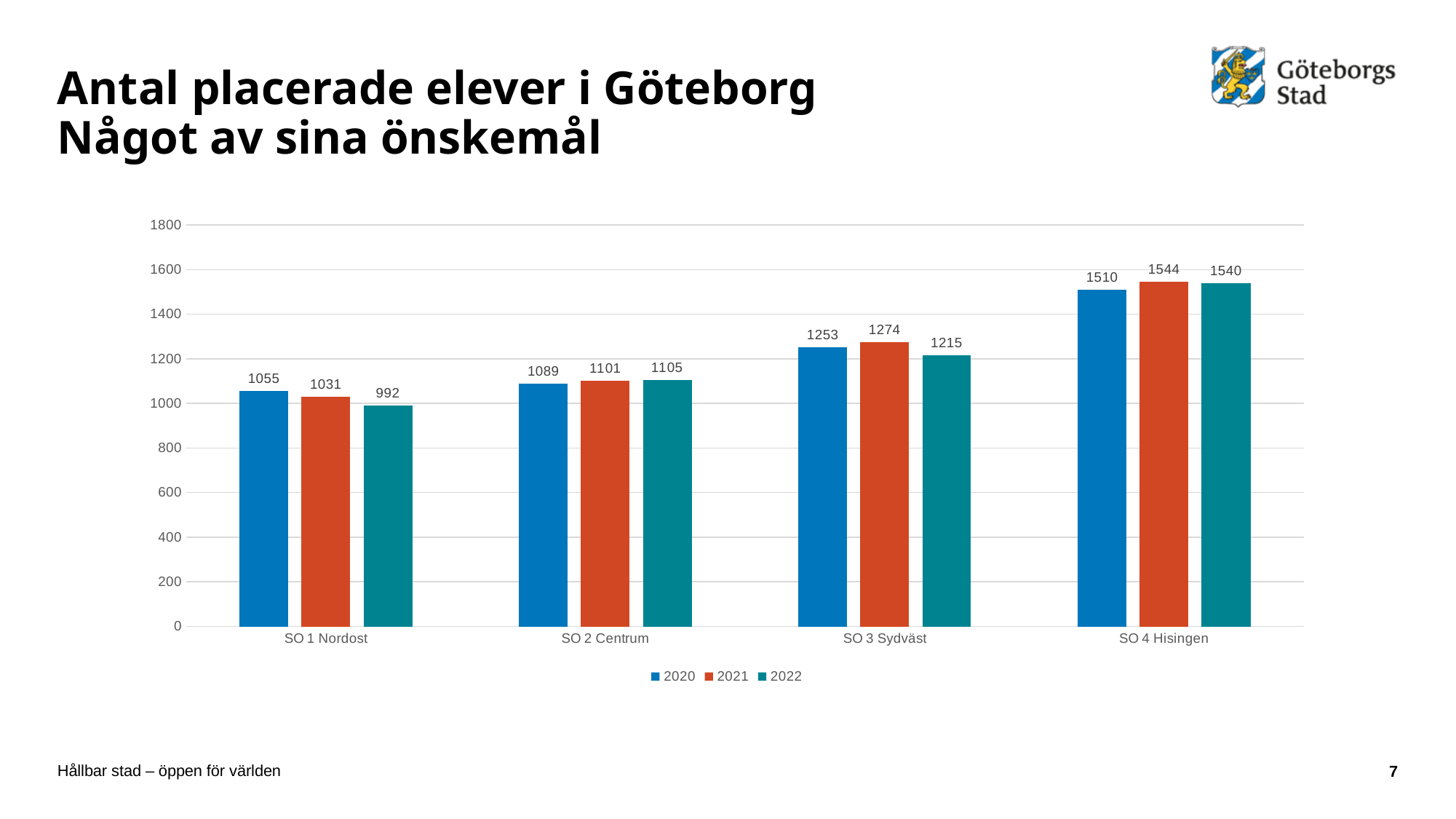
What is the value for SO 1 Nordost in 2022? 992 What is the value for SO 3 Sydväst in 2020? 1253 Which category has the lowest value in 2020? SO 1 Nordost What kind of chart is shown on the slide? Bar chart Which category has the highest value in 2022? SO 4 Hisingen Is the value for SO 4 Hisingen in 2020 greater or less than 1400? greater What is the difference between the 2021 and 2022 values for SO 3 Sydväst? 59 Do the 2022 values rise or fall from SO 1 Nordost to SO 4 Hisingen? Rise How many series does the legend list? 3 How many categories are shown on the x axis? 4 Which is larger: the 2020 value for SO 2 Centrum or the 2020 value for SO 1 Nordost? SO 2 Centrum What is the value for SO 4 Hisingen in 2021? 1544